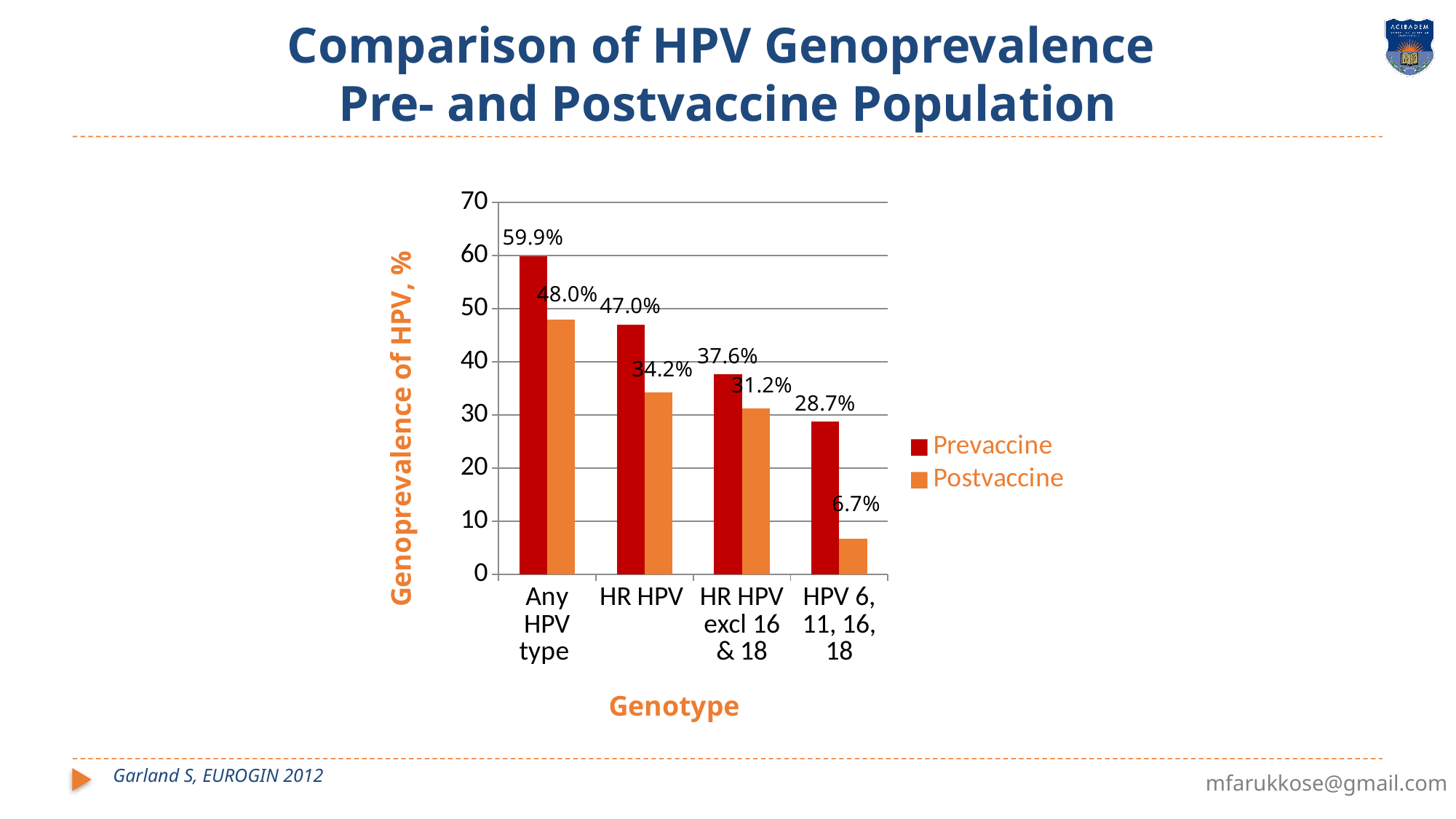
What type of chart is shown on the slide? Bar chart How many series does the legend list? 2 How many genotype categories are shown on the x axis? 4 What is the difference between the Prevaccine and Postvaccine values for Any HPV type? 11.9% What is the Prevaccine value for Any HPV type? 59.9% What is the Postvaccine value for HR HPV? 34.2% Which genotype category has the lowest Postvaccine value? HPV 6, 11, 16, 18 What is the Postvaccine value for HPV 6, 11, 16, 18? 6.7% What is the difference between the Prevaccine and Postvaccine values for HPV 6, 11, 16, 18? 22.0% Which genotype category has the highest Prevaccine value? Any HPV type Which is larger: the Postvaccine value for Any HPV type or the Prevaccine value for HR HPV? Postvaccine value for Any HPV type What is the Prevaccine value for HR HPV excl 16 & 18? 37.6%